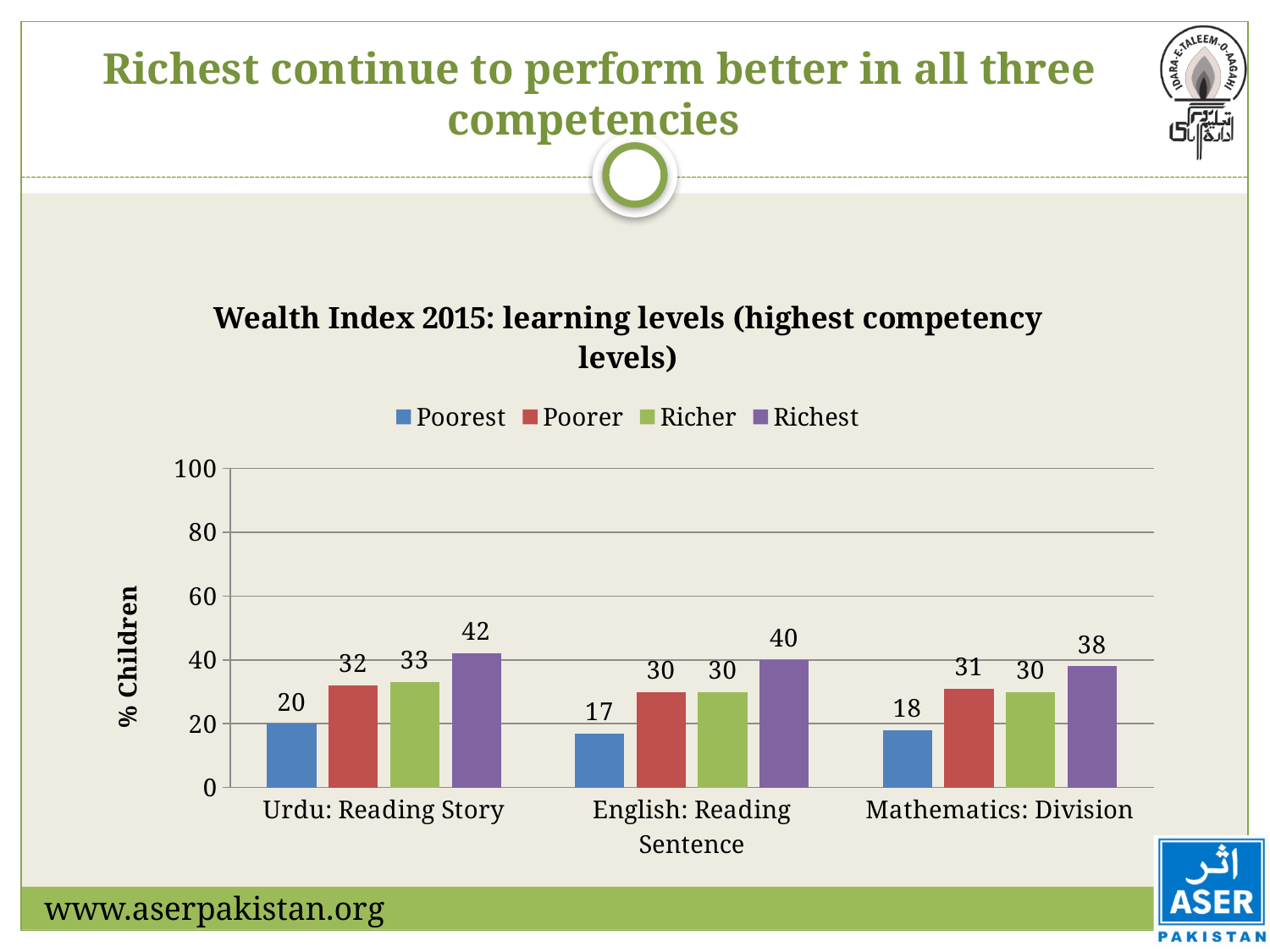
How many series does the legend list? 4 What is the label of the y axis? % Children What kind of chart is shown on the slide? Bar chart What is the value for Poorest in English: Reading Sentence? 17 Which is larger: the Richest value in Urdu: Reading Story or the Richest value in Mathematics: Division? Urdu: Reading Story How many competency categories are shown on the x axis? 3 Which wealth group has the lowest value in Urdu: Reading Story? Poorest Is the value for Richest in English: Reading Sentence greater or less than 20? greater What is the value for Poorer in Mathematics: Division? 31 What is the difference between the Richest and Poorest values in English: Reading Sentence? 23 What is the value for Richest in Urdu: Reading Story? 42 Which wealth group has the highest value in Mathematics: Division? Richest